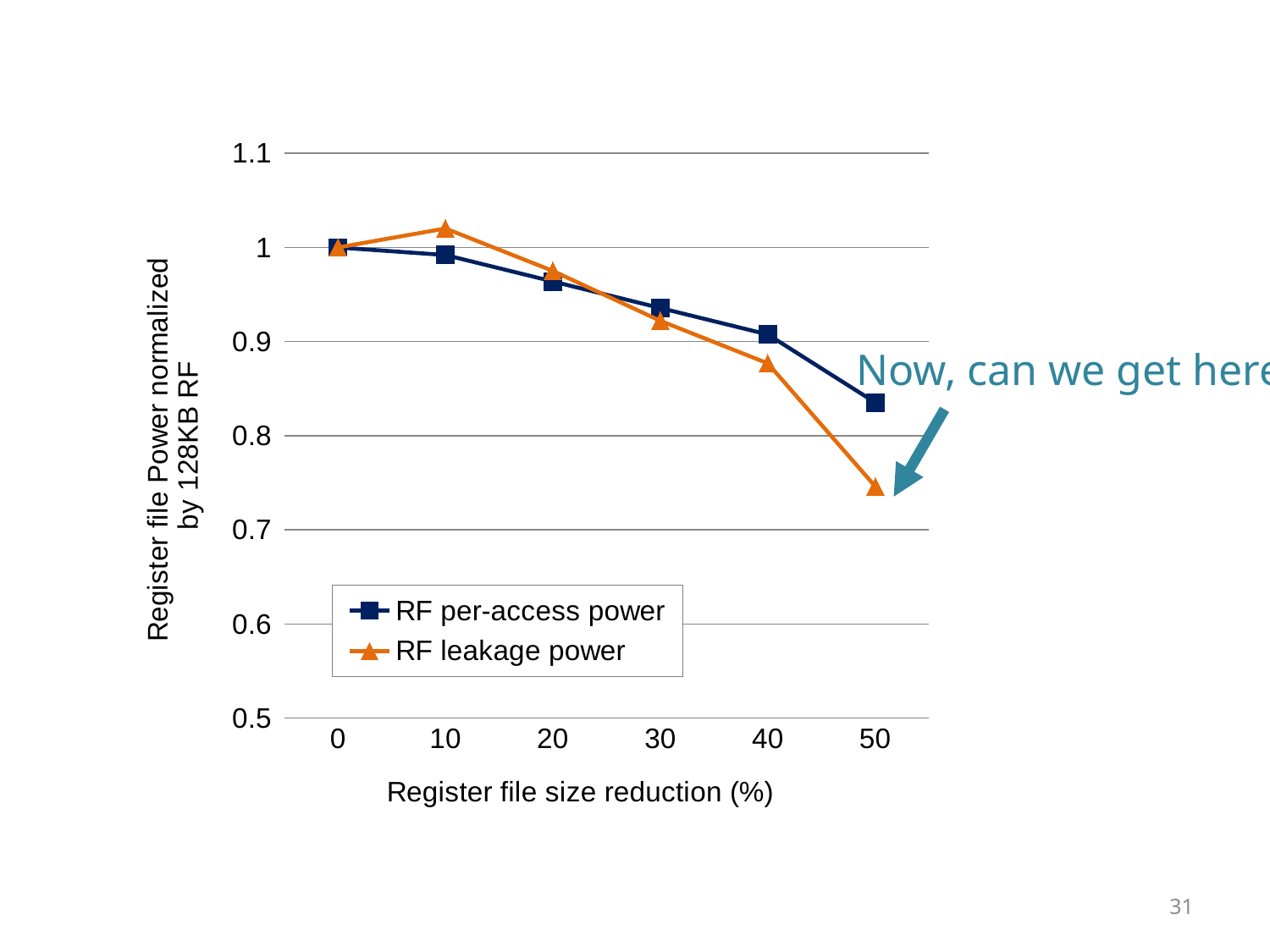
How many series does the legend list? 2 How many data points are plotted for the RF leakage power series? 6 Overall, does RF per-access power rise or fall as register file size reduction increases? fall Is the value of RF leakage power at 40% register file size reduction greater or less than 0.9? less At 50% register file size reduction, which series has the larger value, RF per-access power or RF leakage power? RF per-access power At which register file size reduction does RF leakage power reach its lowest value? 50 What is the value of RF per-access power at 0% register file size reduction? 1 Is the value of RF leakage power at 10% register file size reduction greater or less than 1? greater Is the value of RF leakage power at 50% register file size reduction greater or less than 0.8? less What is the title of the x axis? Register file size reduction (%) What kind of chart is shown on the slide? line chart